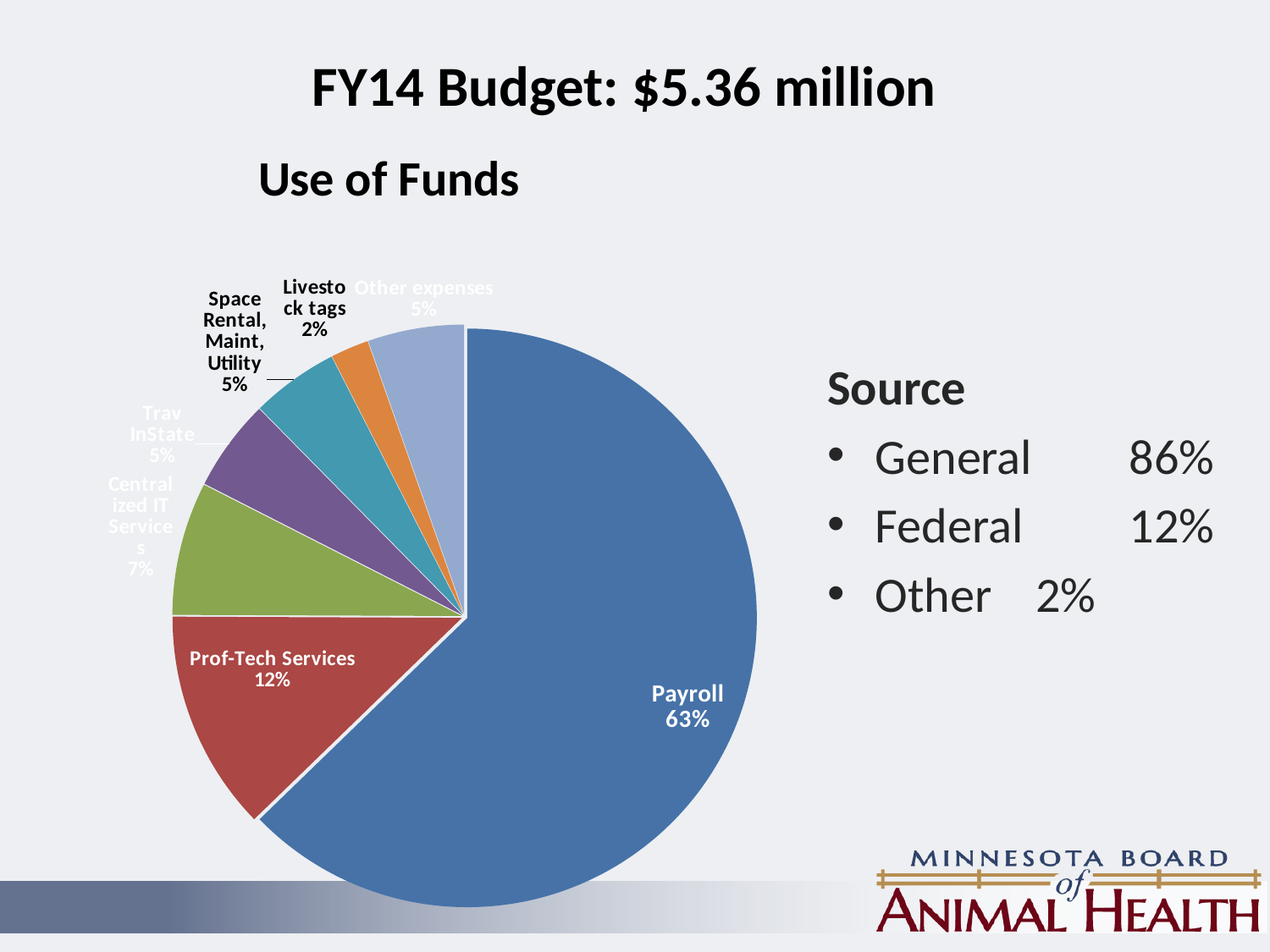
In the Use of Funds pie chart, which is larger: Prof-Tech Services or Space Rental, Maint, Utility? Prof-Tech Services In the Use of Funds pie chart, what share of the budget goes to Payroll? 63% In the Use of Funds pie chart, what percentage is shown for Space Rental, Maint, Utility? 5% In the Use of Funds pie chart, what percentage is shown for Centralized IT Services? 7% What is the title of the pie chart on the slide? Use of Funds Which category has the smallest slice in the Use of Funds pie chart? Livestock tags In the Use of Funds pie chart, what percentage is shown for Livestock tags? 2% In the Use of Funds pie chart, what percentage is labelled for Prof-Tech Services? 12% In the Use of Funds pie chart, how many percentage points larger is Payroll than Prof-Tech Services? 51 percentage points What kind of chart is shown under "Use of Funds"? Pie chart How many slices does the Use of Funds pie chart have? 7 Which category has the largest slice in the Use of Funds pie chart? Payroll